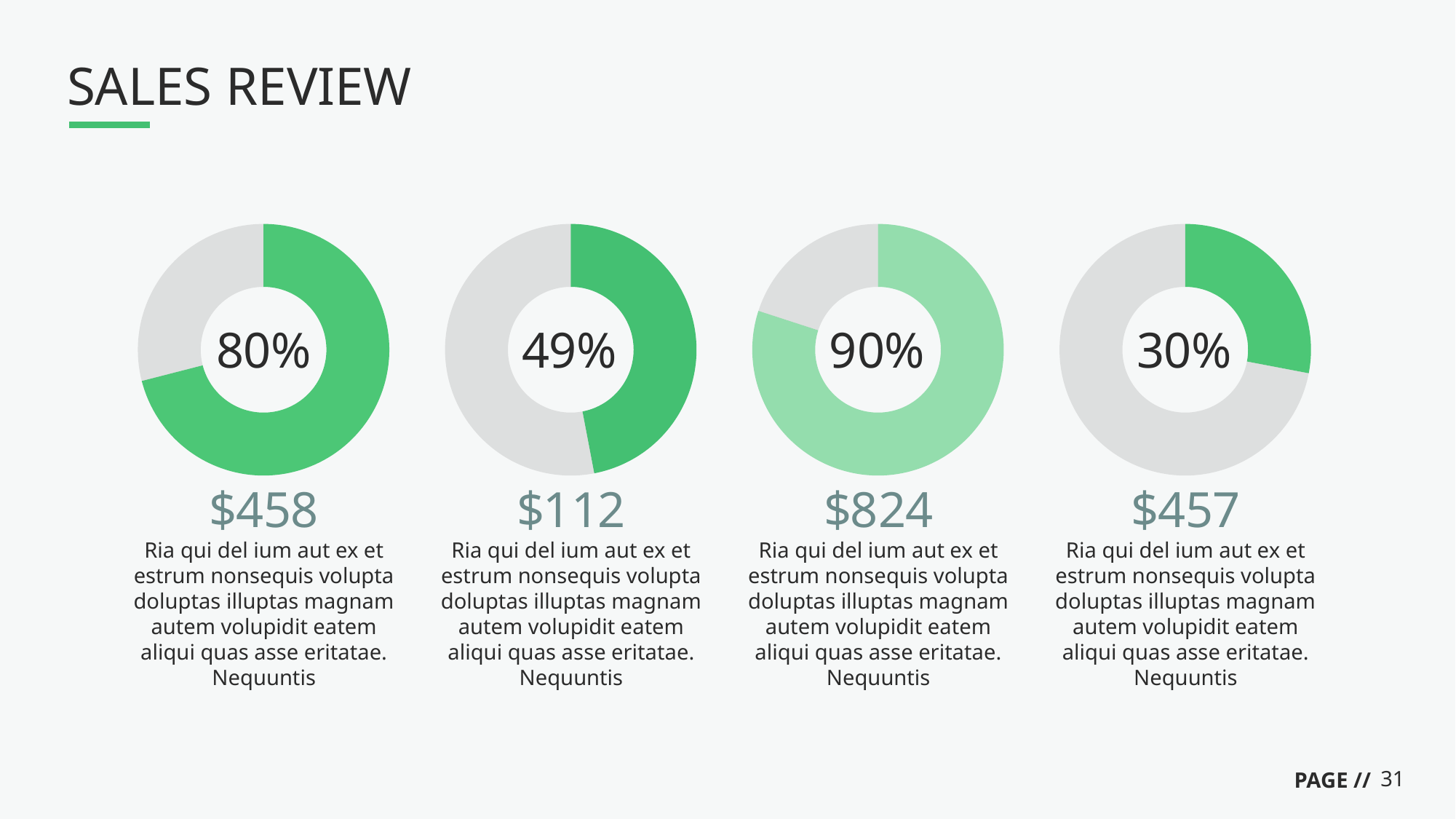
What is the title of the slide containing the donut charts? SALES REVIEW What is the difference between the percentage in the leftmost donut chart and the percentage in the rightmost donut chart? 50% What percentage is shown in the centre of the rightmost donut chart? 30% Which of the four donut charts shows the highest percentage? The third from the left (90%) What percentage is shown in the centre of the second donut chart from the left? 49% What dollar value is printed below the third donut chart from the left? $824 What percentage is shown in the centre of the leftmost donut chart? 80% Which is larger: the percentage in the leftmost donut chart or the percentage in the second donut chart from the left? The leftmost (80%) What percentage is shown in the centre of the third donut chart from the left? 90% How many donut charts are shown on the slide? 4 What dollar value is printed below the rightmost donut chart? $457 Which of the four donut charts shows the lowest percentage? The rightmost (30%)